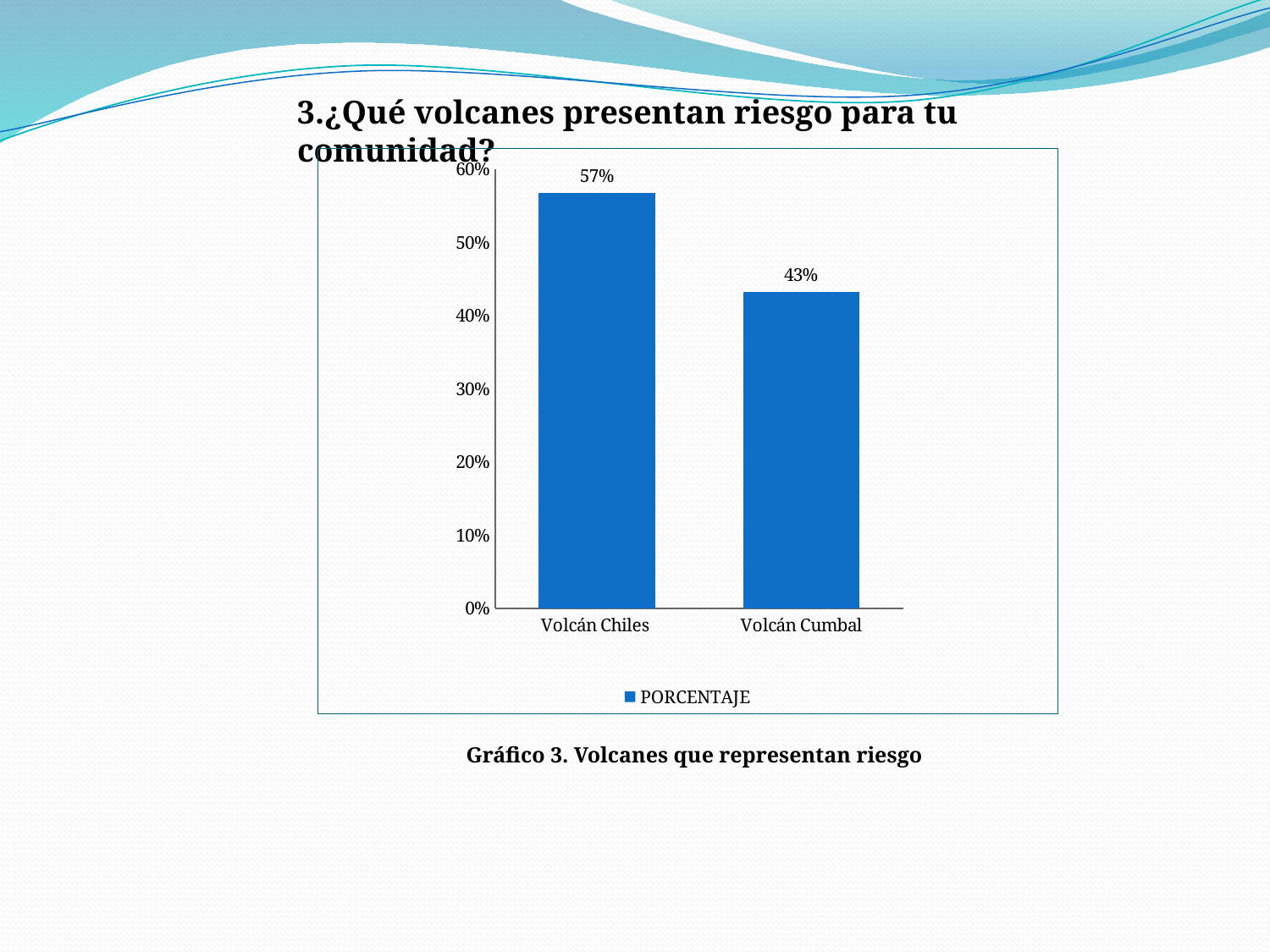
Is the value for Volcán Cumbal greater or less than 50%? less Which volcano has the highest percentage? Volcán Chiles What is the difference between the values for Volcán Chiles and Volcán Cumbal? 14% What is the name of the series shown in the legend? PORCENTAJE Which volcano has the lowest percentage? Volcán Cumbal What is the value for Volcán Chiles? 57% Which is larger, the value for Volcán Chiles or Volcán Cumbal? Volcán Chiles How many series does the legend list? 1 What kind of chart is shown on the slide? Bar chart What is the value for Volcán Cumbal? 43% How many categories are shown on the x axis? 2 Is the value for Volcán Chiles greater or less than 50%? greater